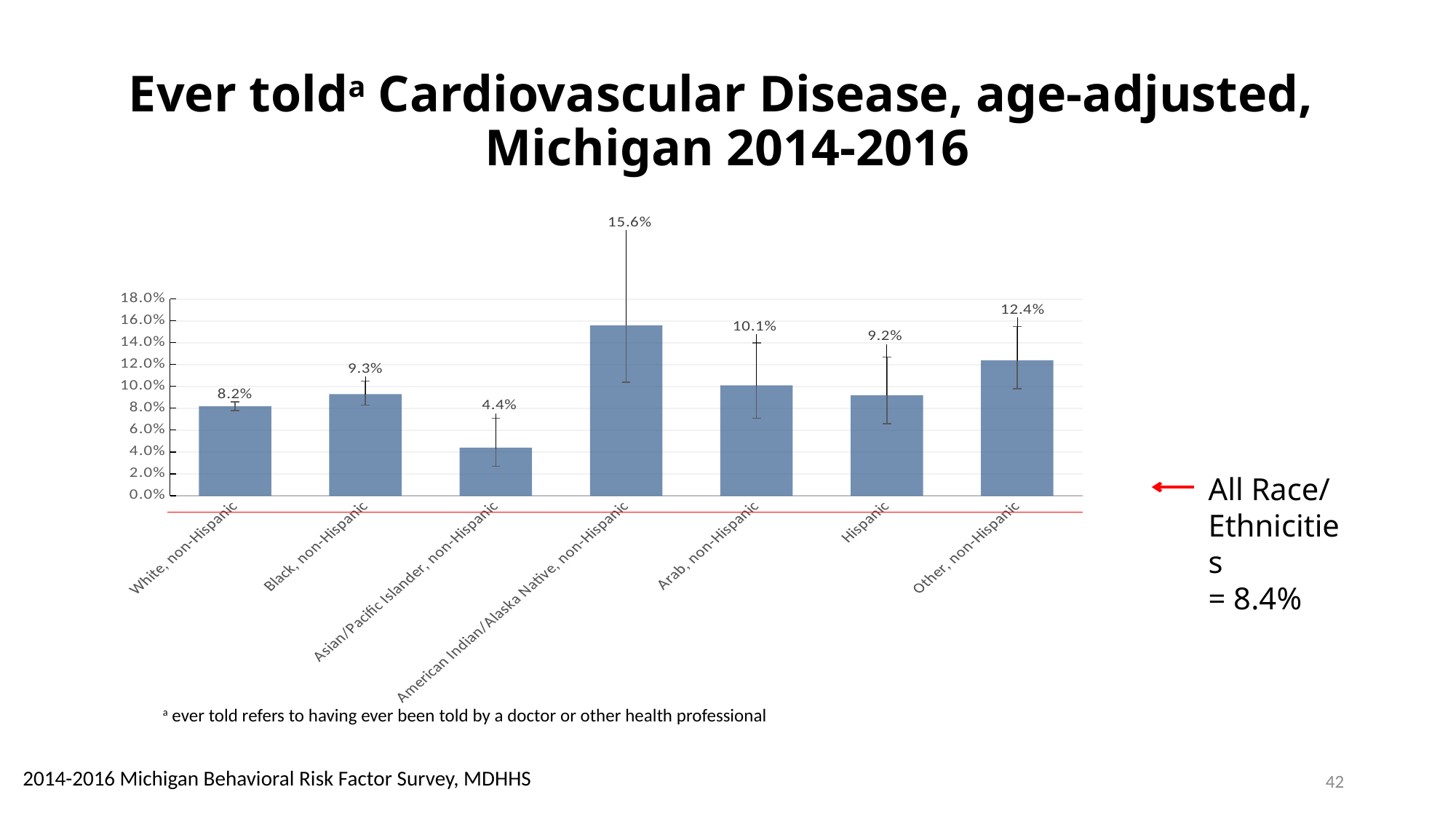
What is the value for Hispanic? 9.2% Which category has the highest value? American Indian/Alaska Native, non-Hispanic Which is larger, the value for Black, non-Hispanic or the value for Other, non-Hispanic? Other, non-Hispanic What is the value for American Indian/Alaska Native, non-Hispanic? 15.6% What is the difference between the values for Arab, non-Hispanic and White, non-Hispanic? 1.9% Is the value for Arab, non-Hispanic greater or less than 8.0%? greater What kind of chart is shown on the slide? bar chart What is the value for All Race/Ethnicities noted beside the chart? 8.4% How many race/ethnicity categories are shown in the chart? 7 Which category has the lowest value? Asian/Pacific Islander, non-Hispanic What is the value for Asian/Pacific Islander, non-Hispanic? 4.4% What is the value for Other, non-Hispanic? 12.4%